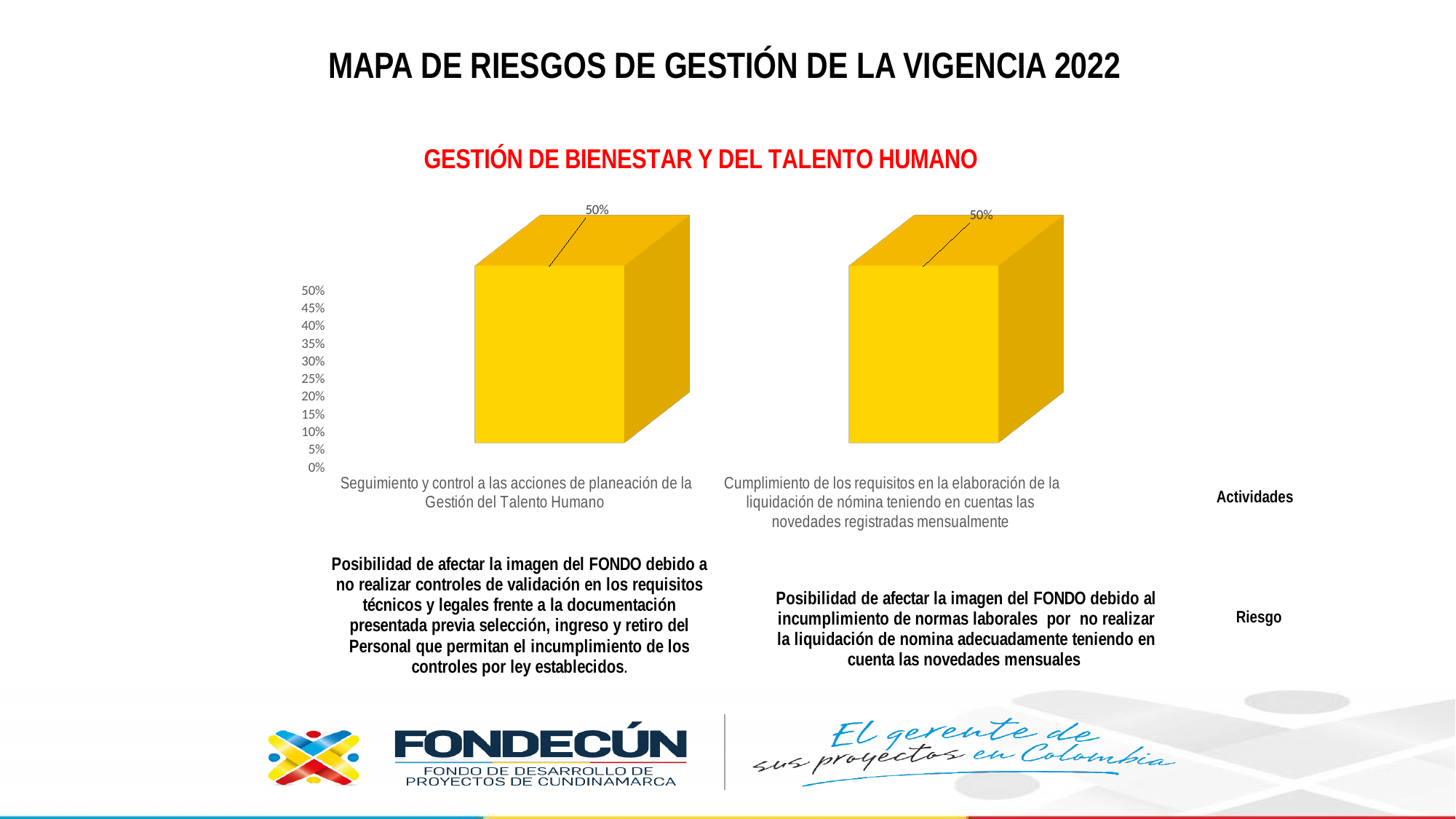
What kind of chart is shown on the slide? Bar chart What is the difference between the value for "Seguimiento y control a las acciones de planeación de la Gestión del Talento Humano" and the value for "Cumplimiento de los requisitos en la elaboración de la liquidación de nómina"? 0% What colour are the bars in the chart? Yellow What is the highest tick value shown on the vertical axis? 50% Is the value for "Cumplimiento de los requisitos en la elaboración de la liquidación de nómina" greater or less than 10%? greater How many categories (bars) does the chart show? 2 What is the value for "Seguimiento y control a las acciones de planeación de la Gestión del Talento Humano"? 50% What is the value for "Cumplimiento de los requisitos en la elaboración de la liquidación de nómina teniendo en cuentas las novedades registradas mensualmente"? 50% What is the title shown above the chart? GESTIÓN DE BIENESTAR Y DEL TALENTO HUMANO Do the values rise, fall, or stay the same from the first bar to the second bar? Stay the same Is the value for "Seguimiento y control a las acciones de planeación de la Gestión del Talento Humano" greater or less than 25%? greater Do the two bars have the same value or different values? The same value